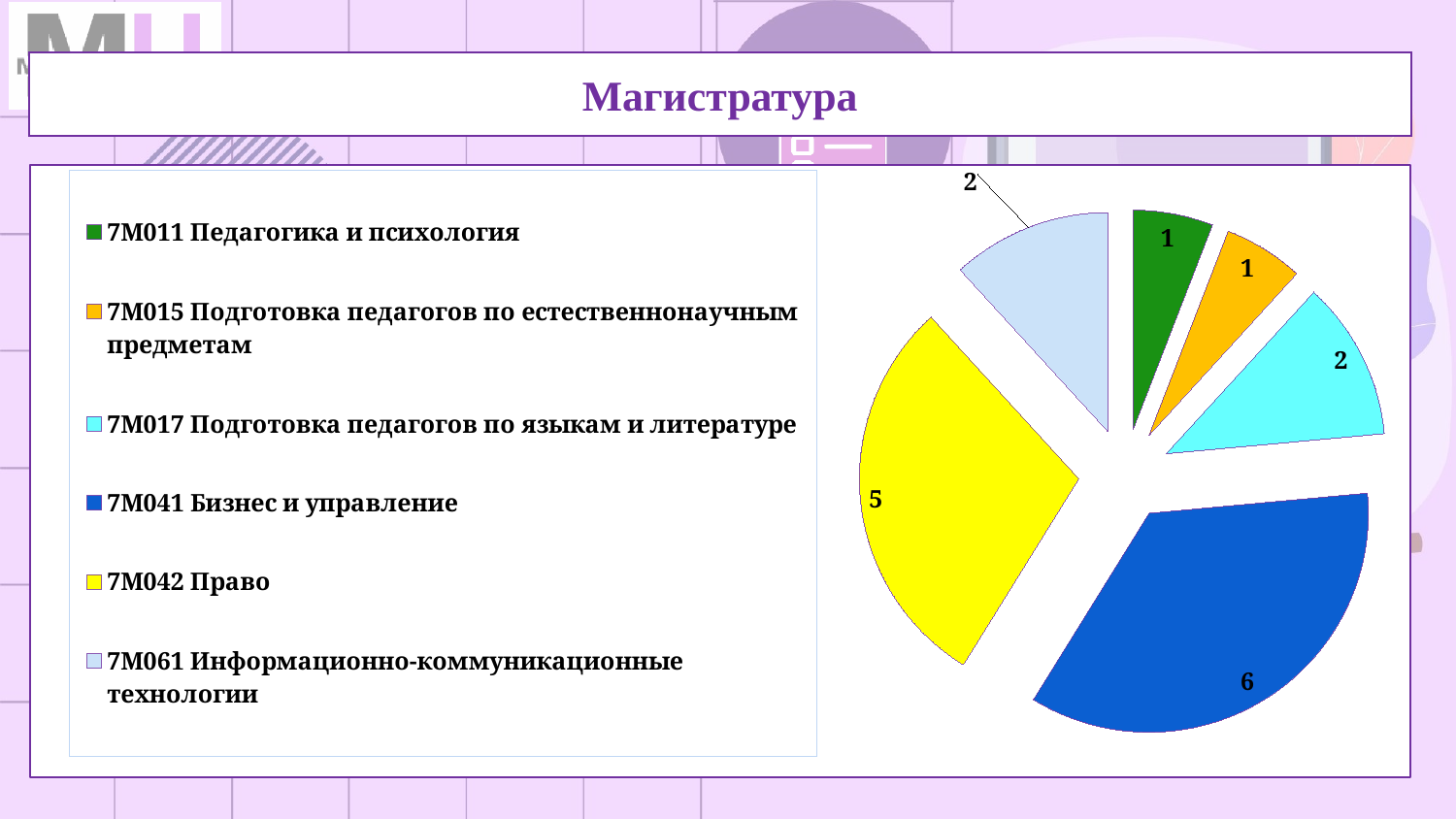
What colour is the slice for 7M042 Право? yellow What type of chart is shown on the slide? pie chart What is the value for 7M041 Бизнес и управление? 6 What is the total of all the values in the pie chart? 17 What is the value for 7M042 Право? 5 How many categories does the pie chart have? 6 Which is larger, the value for 7M042 Право or the value for 7M041 Бизнес и управление? 7M041 Бизнес и управление What is the value for 7M061 Информационно-коммуникационные технологии? 2 What is the value for 7M011 Педагогика и психология? 1 Which category has the largest slice of the pie? 7M041 Бизнес и управление What is the difference between the values for 7M041 Бизнес и управление and 7M042 Право? 1 What is the value for 7M017 Подготовка педагогов по языкам и литературе? 2